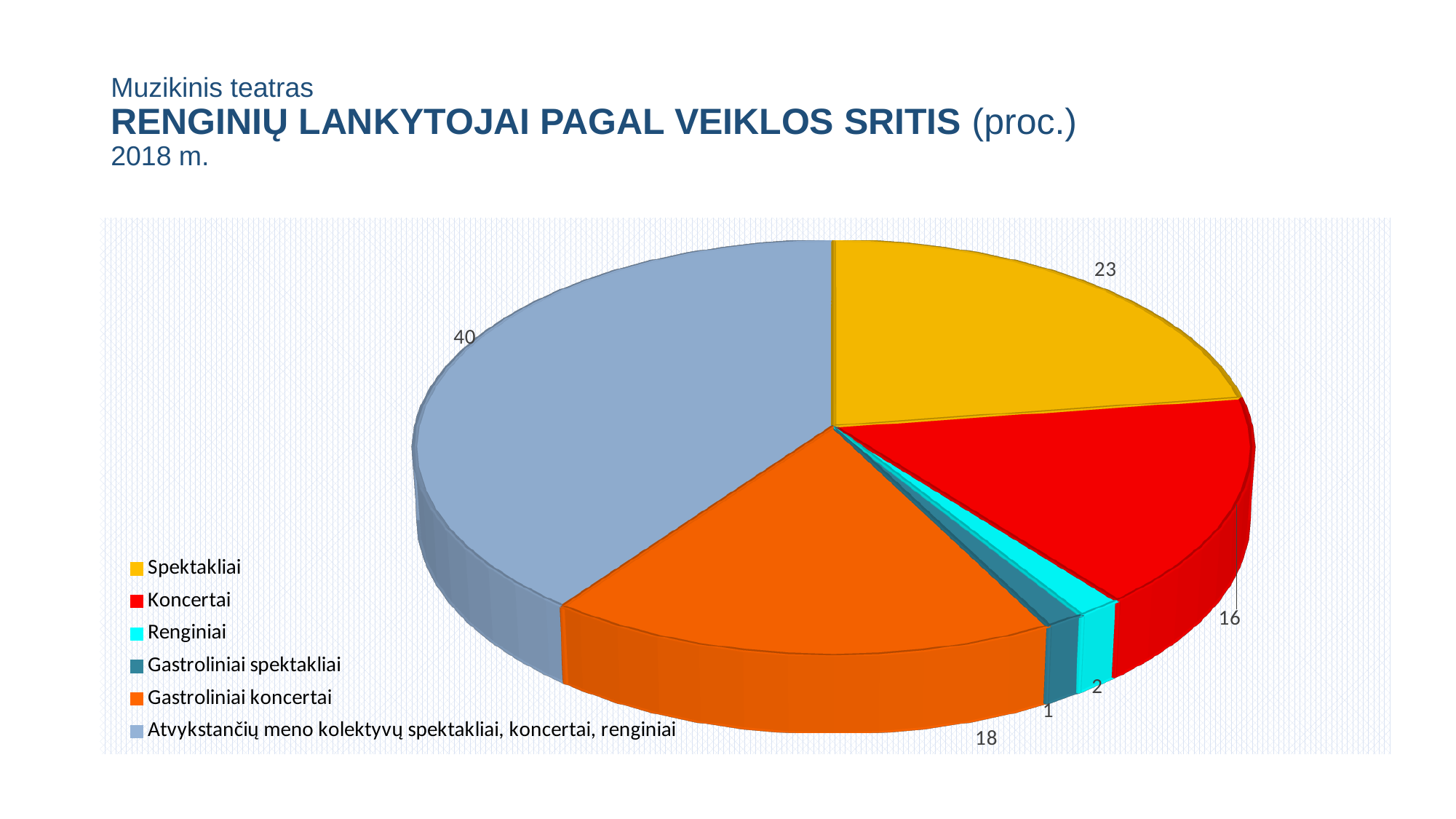
Which category has the largest slice of the pie? Atvykstančių meno kolektyvų spektakliai, koncertai, renginiai Which category has the smallest slice of the pie? Gastroliniai spektakliai What is the value for Gastroliniai koncertai? 18 What is the value for Renginiai? 2 What is the difference between the values for Spektakliai and Koncertai? 7 What is the value for Koncertai? 16 What type of chart is shown on the slide? pie chart How many categories does the pie chart have? 6 What is the difference between the values for Atvykstančių meno kolektyvų spektakliai, koncertai, renginiai and Gastroliniai koncertai? 22 Which is larger, the value for Gastroliniai koncertai or the value for Koncertai? Gastroliniai koncertai Which colour represents Koncertai in the legend? red What is the value for Spektakliai? 23